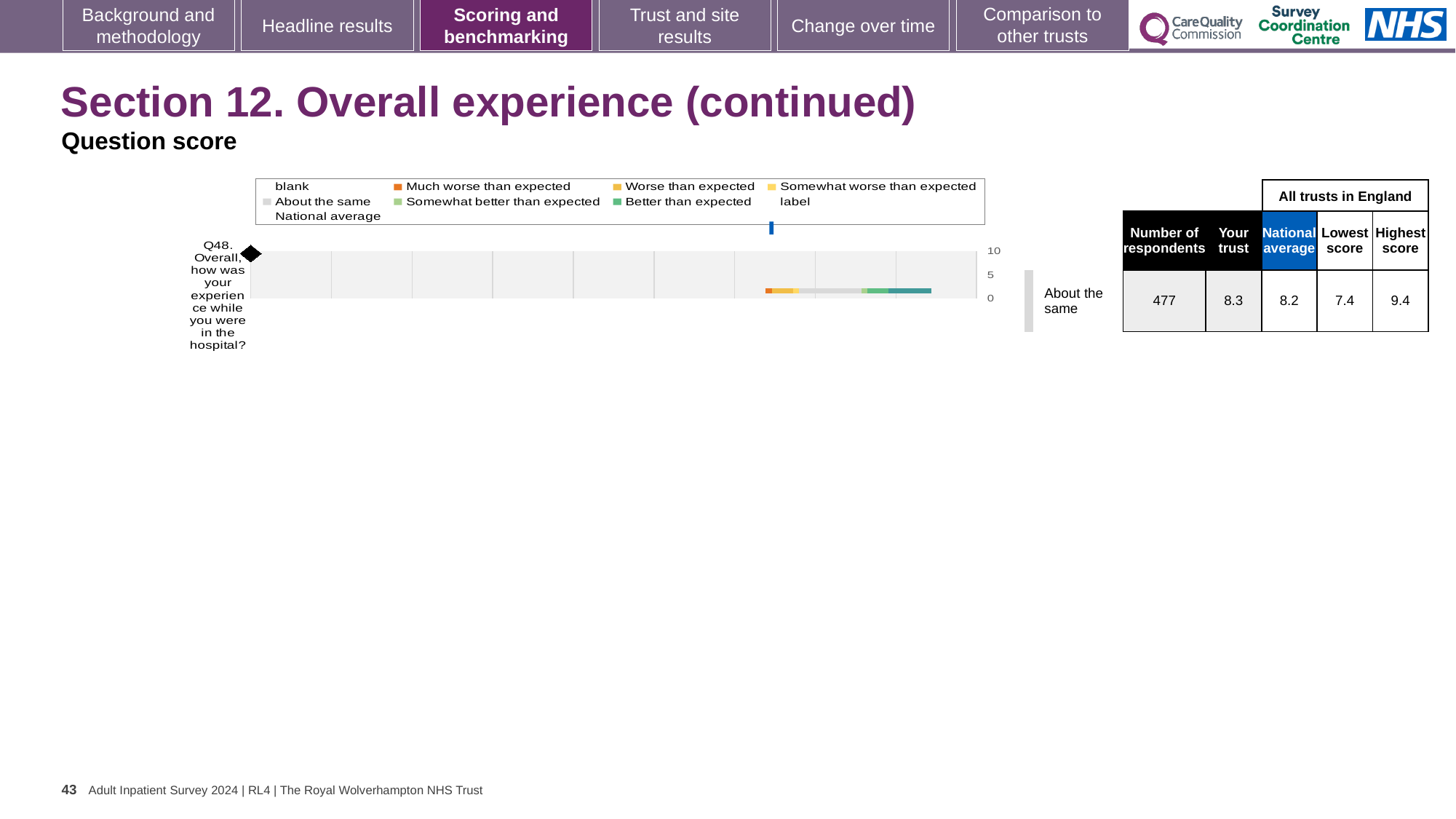
According to the table beside the chart, what is the national average score for Q48? 8.2 Which question is plotted in the chart? Q48. Overall, how was your experience while you were in the hospital? Which is larger for Q48: the 'Your trust' score or the national average? Your trust What is the difference between the highest score and the lowest score shown in the table for Q48? 2.0 What is the highest tick value shown on the chart's axis? 10 According to the table beside the chart, what is the 'Your trust' score for Q48? 8.3 According to the table beside the chart, how many respondents answered Q48? 477 According to the table beside the chart, what is the lowest score among all trusts in England for Q48? 7.4 What kind of chart is shown on the slide? bar chart According to the table beside the chart, what is the highest score among all trusts in England for Q48? 9.4 How many survey questions are plotted in the chart? 1 Which legend entry is shown in orange? Much worse than expected